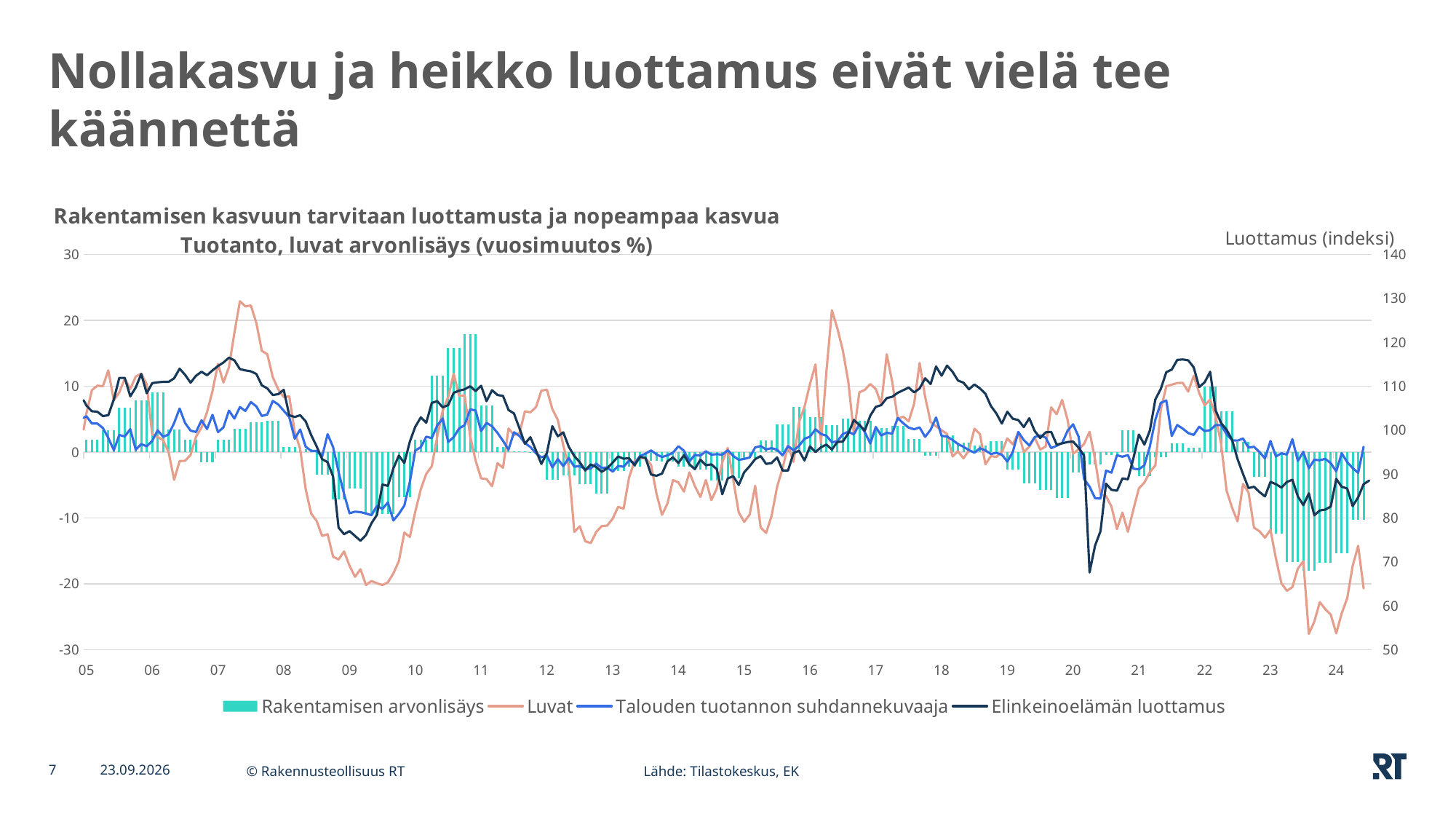
Does the Elinkeinoelämän luottamus series rise or fall from 2018 to 2019? fall What kind of chart is shown on the slide? A combined bar and line chart What is the title of the chart? Rakentamisen kasvuun tarvitaan luottamusta ja nopeampaa kasvua Is the lowest value of the Elinkeinoelämän luottamus series in 2020 greater or less than 80 on the right axis? less How many series does the chart legend list? 4 Is the highest Rakentamisen arvonlisäys bar around 2011 greater or less than 10 on the left axis? greater Is the lowest value of the Luvat series in 2023 greater or less than -20 on the left axis? less Which series in the chart is drawn as bars? Rakentamisen arvonlisäys How many year labels are shown on the x axis? 20 Does the Luvat series rise or fall from 2022 to 2023? fall